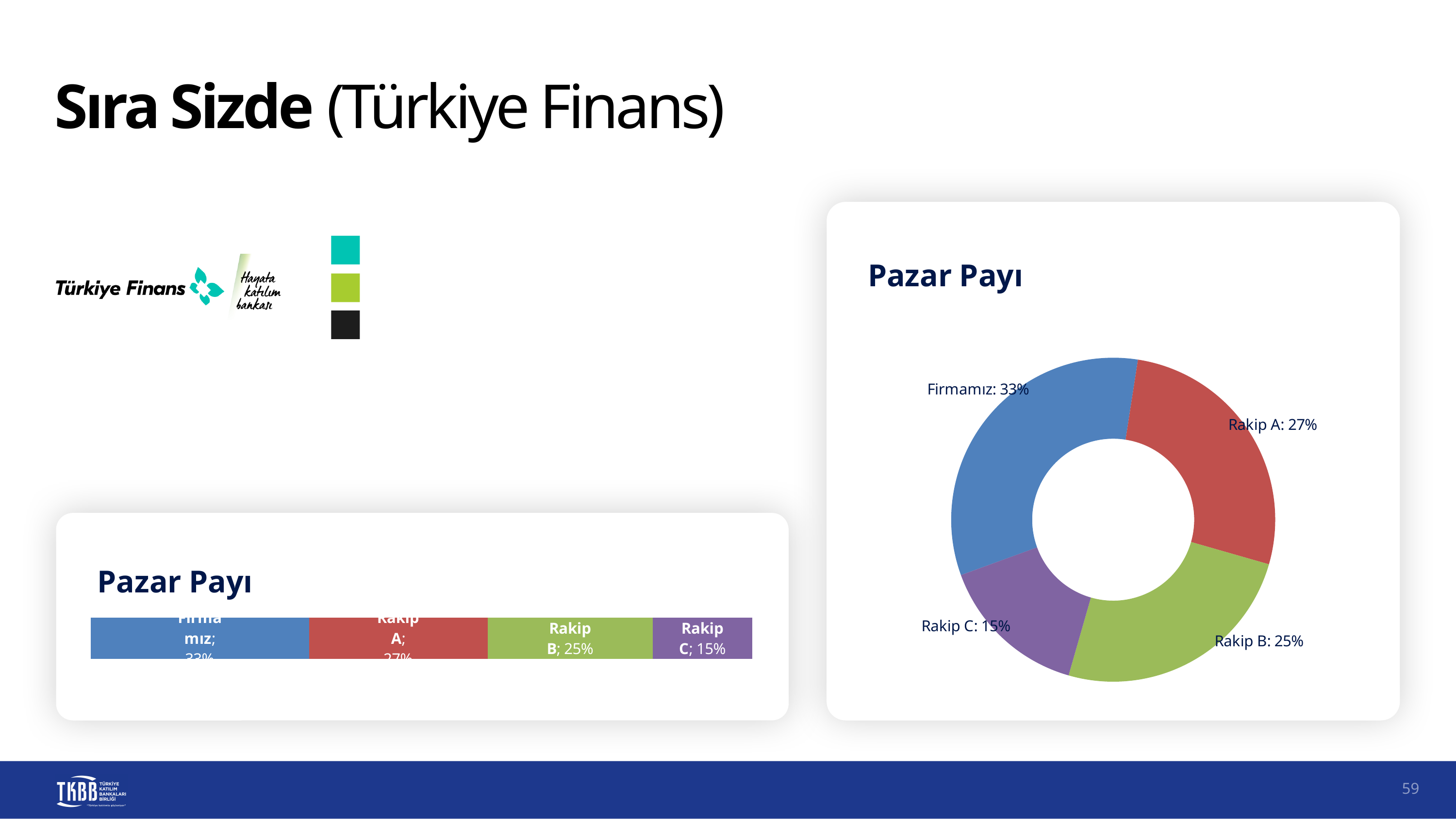
In the stacked bar chart on the left, what is the value for Rakip C? 15% What is the title of the chart on the right side of the slide? Pazar Payı In the doughnut chart on the right, what is the share for Firmamız? 33% In the stacked bar chart on the left, which is larger, the value for Rakip A or Rakip B? Rakip A How many categories are shown in the doughnut chart on the right? 4 In the doughnut chart on the right, what is the difference between the shares of Firmamız and Rakip C? 18% In the stacked bar chart on the left, what is the value for Rakip B? 25% In the doughnut chart on the right, which category has the largest share? Firmamız What kind of chart is shown in the bottom-left panel of the slide? Stacked bar chart In the doughnut chart on the right, what is the share for Rakip A? 27% What kind of chart is shown on the right side of the slide? Doughnut chart In the doughnut chart on the right, which category has the smallest share? Rakip C